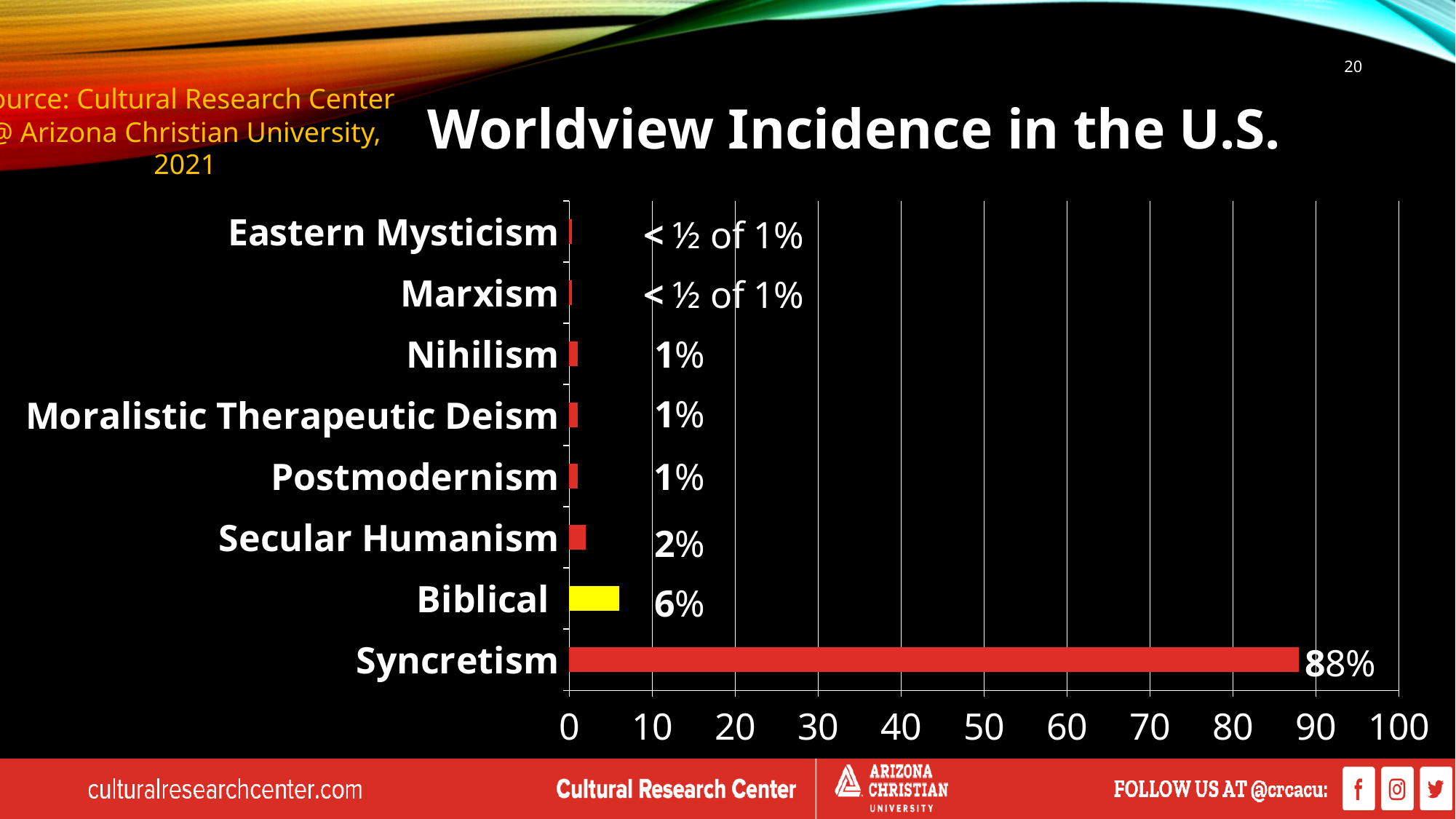
What is the difference between the values for Biblical and Secular Humanism? 4% What is the value for Biblical? 6% What label is shown for Marxism? < ½ of 1% Which is larger, the value for Biblical or the value for Secular Humanism? Biblical What is the difference between the values for Syncretism and Biblical? 82% What is the value for Syncretism? 88% How many categories are shown in the chart? 8 What is the value for Secular Humanism? 2% Which category has the highest value? Syncretism What is the value for Postmodernism? 1% What kind of chart is shown on the slide? bar chart Is the value for Syncretism greater or less than 80? greater